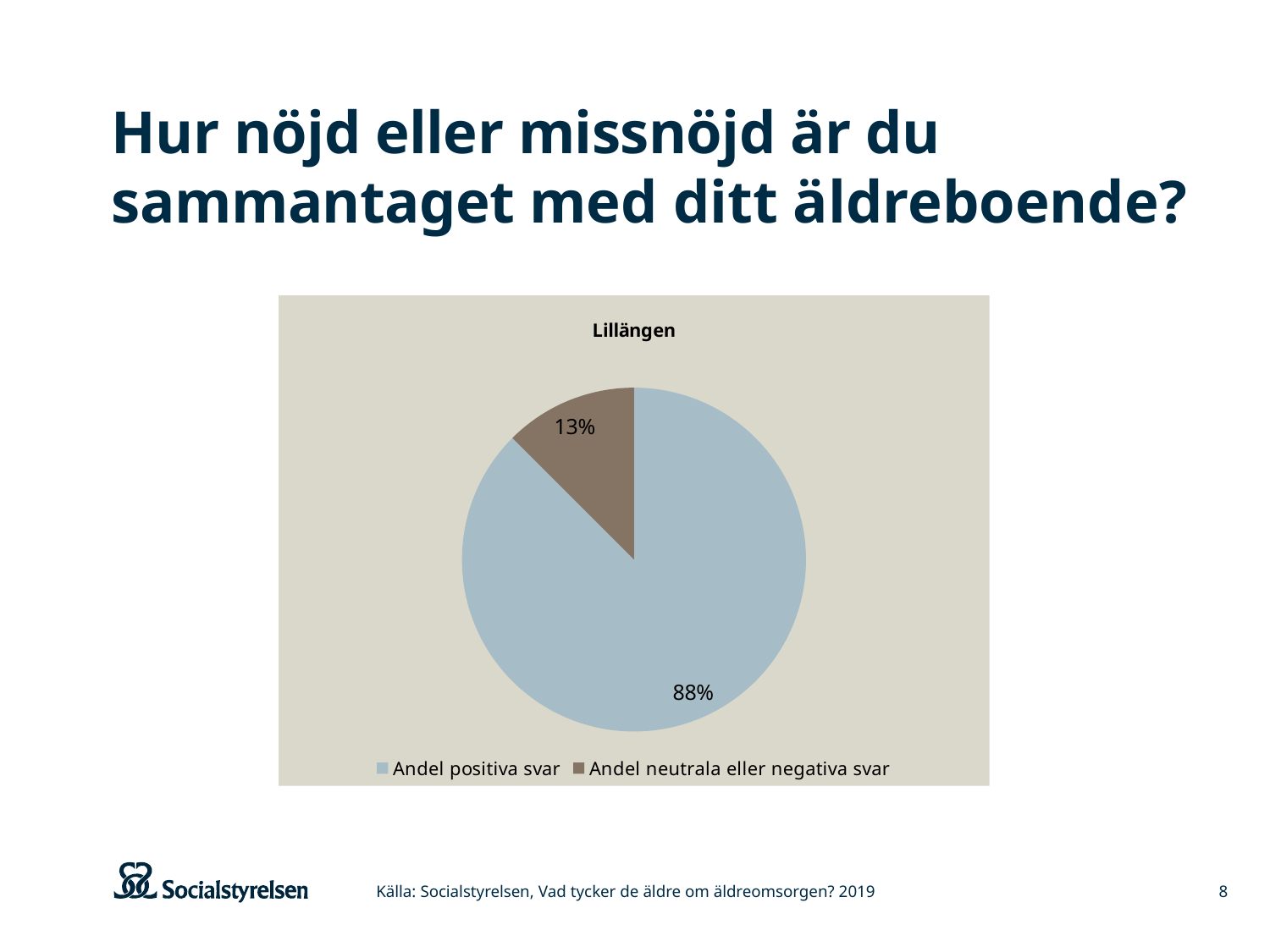
What share of the pie is 'Andel neutrala eller negativa svar'? 13% Which slice is the largest? Andel positiva svar What is the chart's title? Lillängen Which is larger, 'Andel positiva svar' or 'Andel neutrala eller negativa svar'? Andel positiva svar What kind of chart is shown on the slide? pie chart What share of the pie is 'Andel positiva svar'? 88% Which slice is the smallest? Andel neutrala eller negativa svar How many slices does the pie chart have? 2 What colour is the 'Andel positiva svar' slice? light blue What is the difference between the 'Andel positiva svar' share and the 'Andel neutrala eller negativa svar' share? 75% How many entries does the legend list? 2